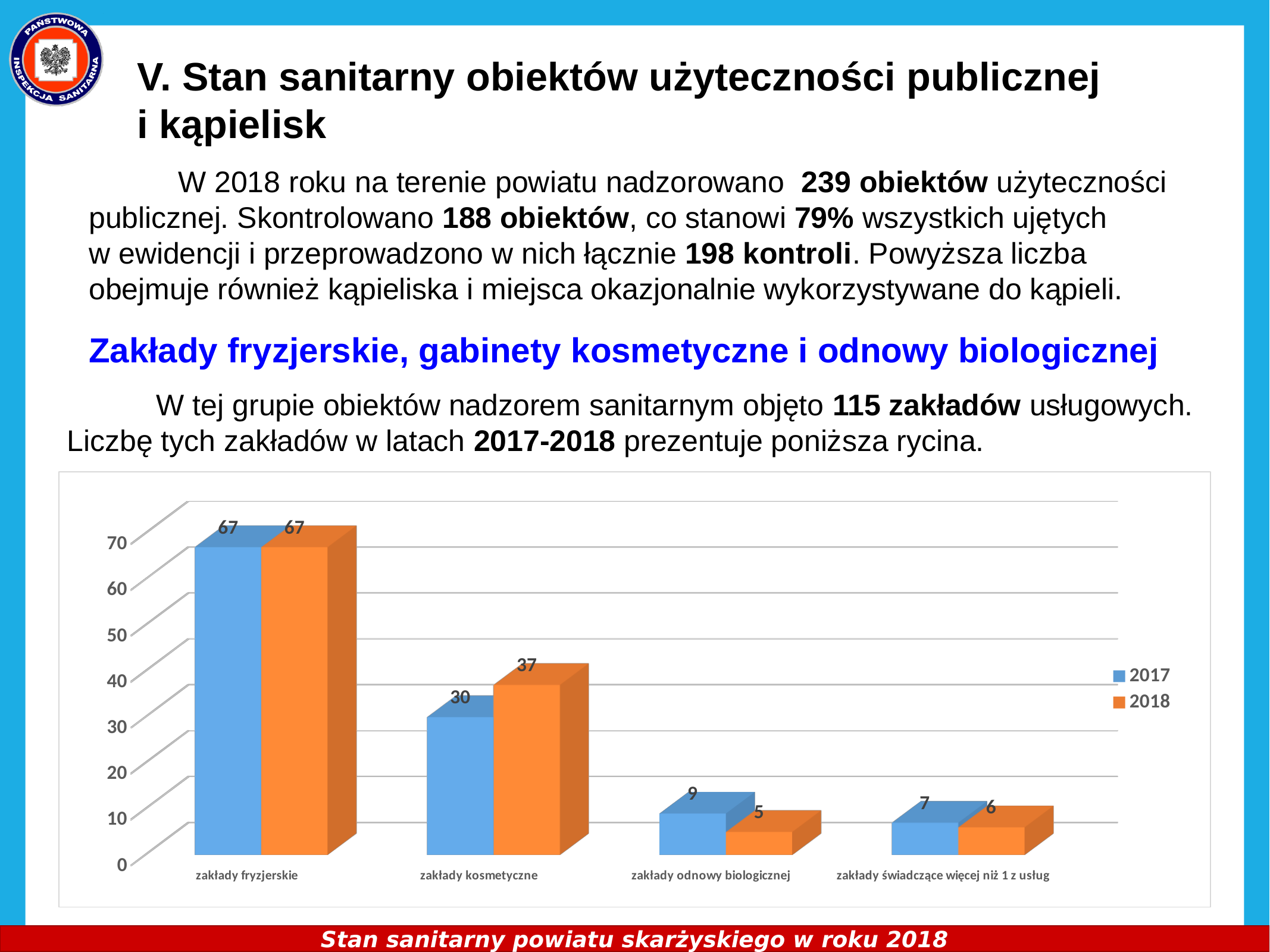
What is the value for zakłady świadczące więcej niż 1 z usług in 2018? 6 Which colour represents the 2018 series in the chart? orange Which category has the highest value in 2017? zakłady fryzjerskie What is the total of the 2017 and 2018 values for zakłady fryzjerskie? 134 How many series does the legend list? 2 What is the difference between the 2018 and 2017 values for zakłady kosmetyczne? 7 Which is larger for zakłady odnowy biologicznej: the 2017 value or the 2018 value? 2017 How many categories are shown on the x axis? 4 What is the value for zakłady odnowy biologicznej in 2017? 9 What kind of chart is shown on the slide? bar chart What is the value for zakłady kosmetyczne in 2018? 37 Which category has the lowest value in 2018? zakłady odnowy biologicznej